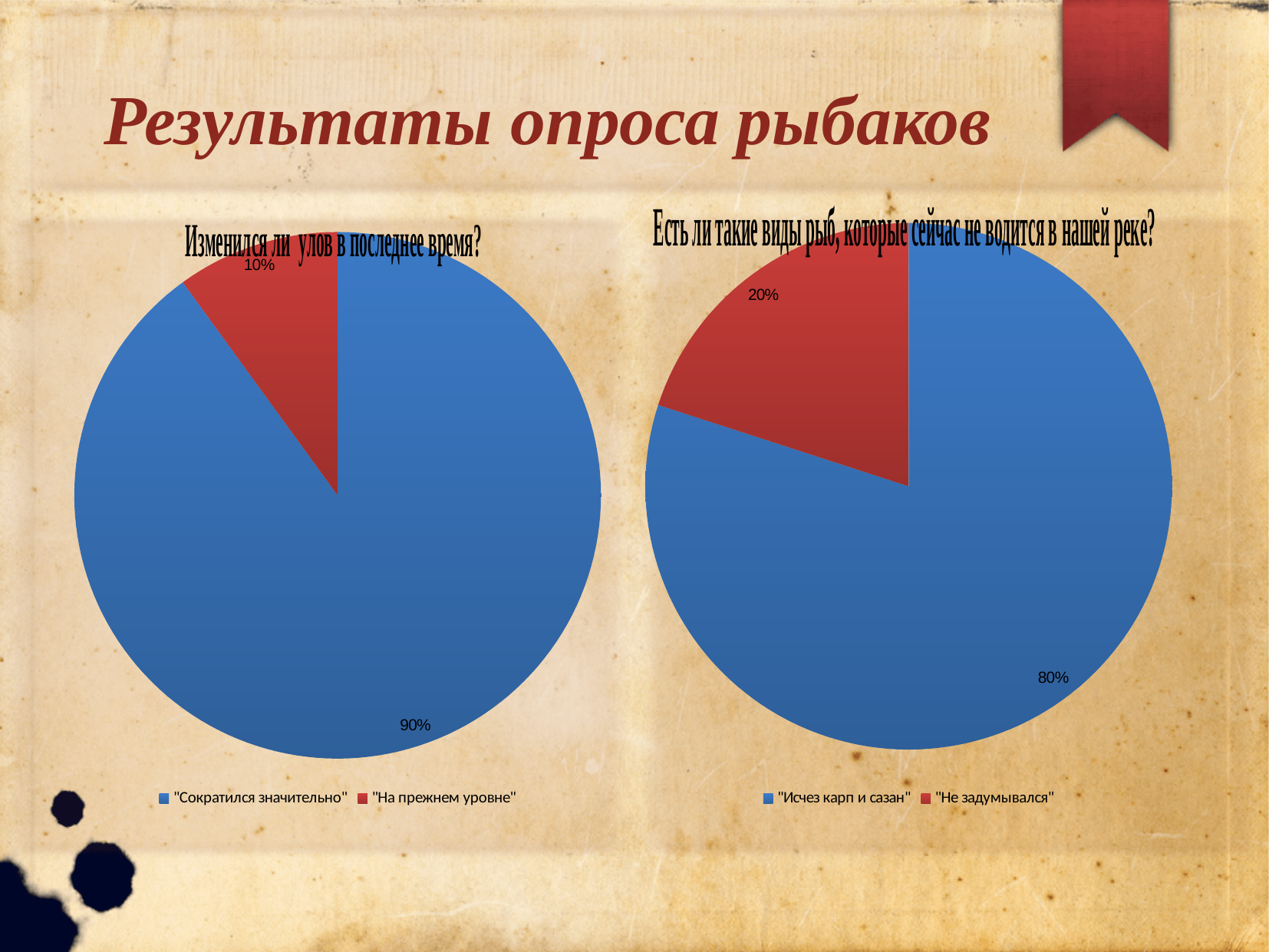
How many slices does the right pie chart have? 2 In the right pie chart, which answer has the smallest slice? "Не задумывался" In the right pie chart, what share of respondents answered "Не задумывался"? 20% In the left pie chart, what share of respondents answered "Сократился значительно"? 90% In the right pie chart, what is the difference between the "Исчез карп и сазан" and "Не задумывался" shares? 60% What type of chart is used on the left side of the slide? Pie chart In the right pie chart, what colour is the "Исчез карп и сазан" slice? Blue In the right pie chart, what share of respondents answered "Исчез карп и сазан"? 80% In the left pie chart, which answer has the largest slice? "Сократился значительно" Which is larger: the "На прежнем уровне" slice in the left chart or the "Не задумывался" slice in the right chart? "Не задумывался" In the left pie chart, what share of respondents answered "На прежнем уровне"? 10% In the left pie chart, what is the difference between the "Сократился значительно" and "На прежнем уровне" shares? 80%